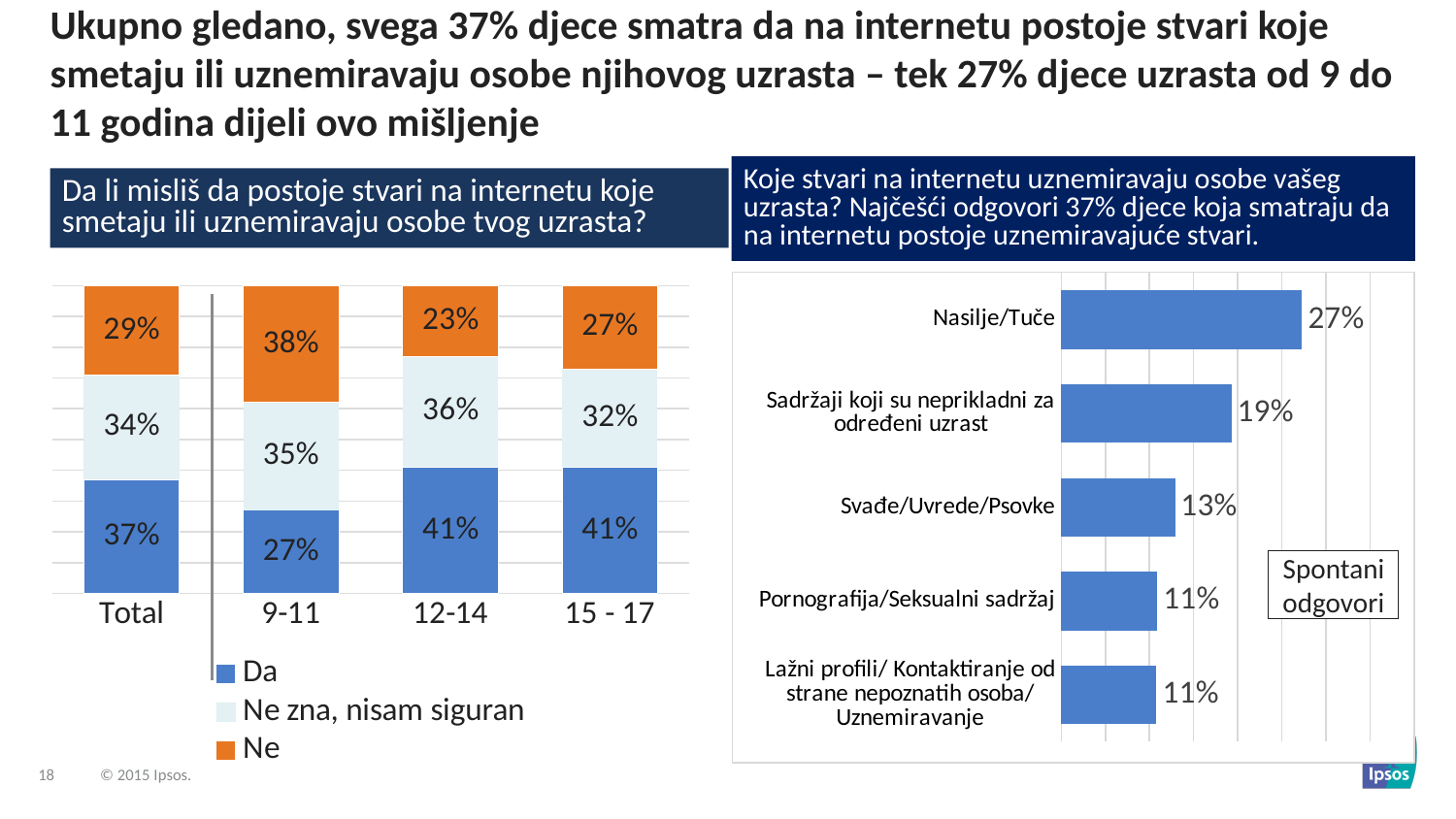
In the left chart, what is the total of the stacked bar for 15 - 17? 100% In the right chart, how many categories are shown? 5 In the right chart, what is the difference between Nasilje/Tuče and Svađe/Uvrede/Psovke? 14% In the left chart, what percentage of the 9-11 age group answered "Da"? 27% In the left chart, which age group has the highest "Ne" share? 9-11 In the left chart, what is the "Ne zna, nisam siguran" value for the 12-14 age group? 36% In the right chart, which category has the highest value? Nasilje/Tuče What kind of chart is the right chart? Bar chart In the left chart, what is the "Ne" value for the Total column? 29% In the left chart, how many series does the legend list? 3 In the left chart, what is the difference between the "Da" values for 12-14 and 9-11? 14% In the right chart, what is the value for Nasilje/Tuče? 27%